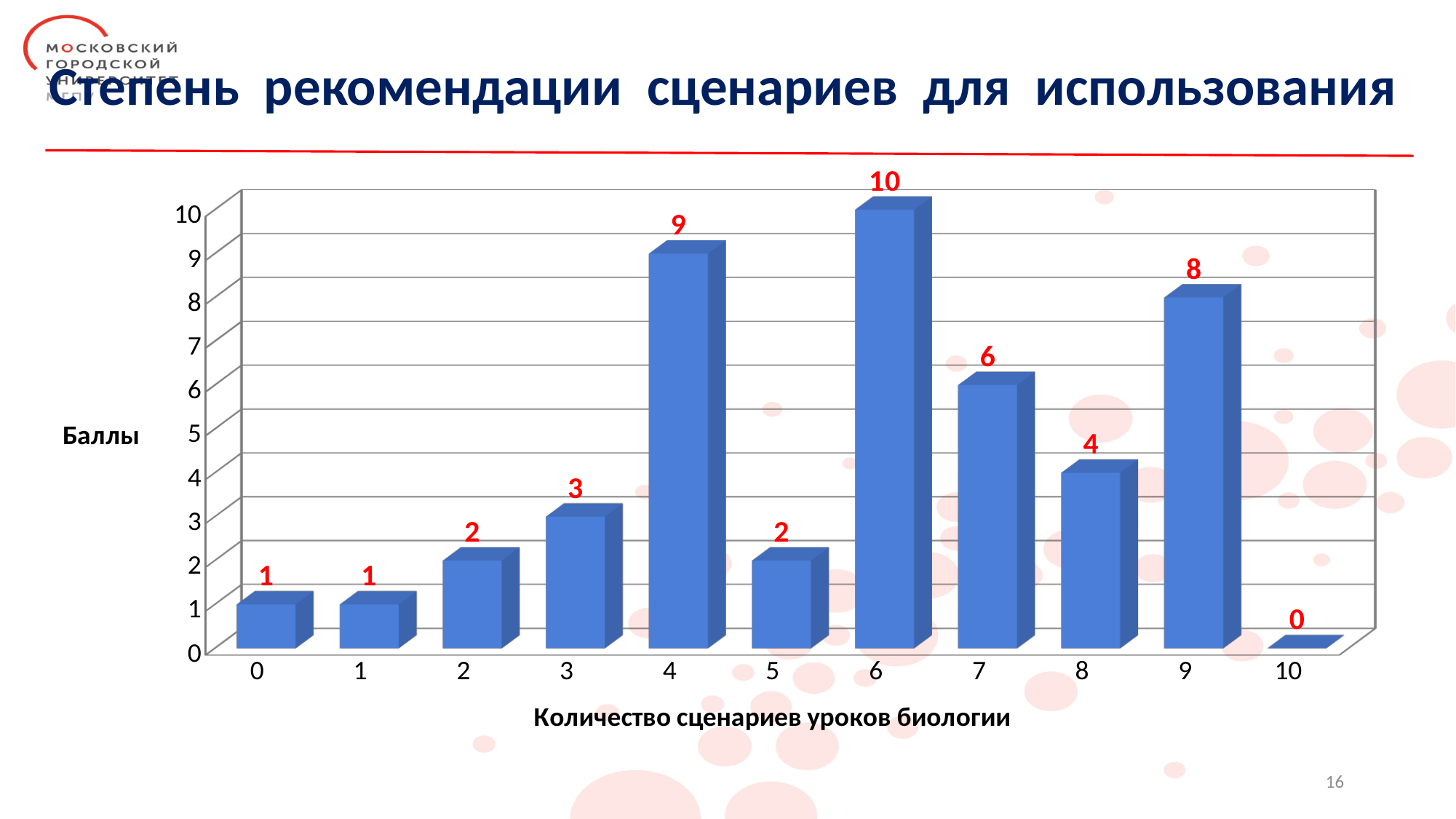
How many categories are shown on the x axis? 11 What is the label of the vertical axis? Баллы What value is shown for category 6 on the x axis? 10 Which category on the x axis has the highest value? 6 What is the difference between the values for categories 9 and 8? 4 Which has a larger value, category 3 or category 5? 3 What value is shown for category 4 on the x axis? 9 What is the difference between the values for categories 6 and 7? 4 What kind of chart is shown on the slide? Bar chart Which category on the x axis has the lowest value? 10 Which has a larger value, category 4 or category 9? 4 What value is shown for category 8 on the x axis? 4